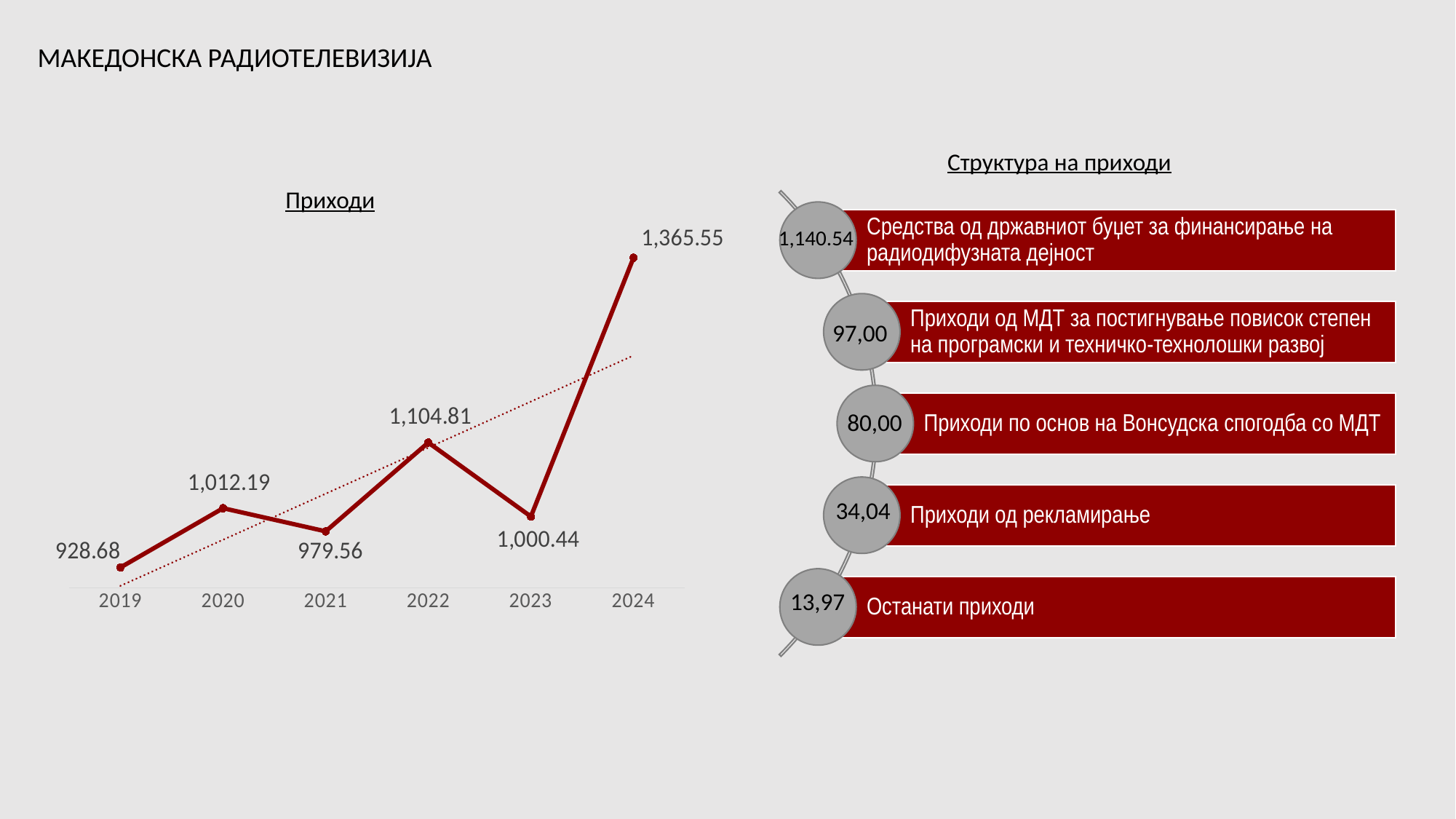
In the 'Приходи' chart, what is the value for 2022? 1,104.81 In the 'Приходи' chart, which year has the highest value? 2024 In the 'Приходи' chart, does the value rise or fall from 2022 to 2023? Fall In the 'Приходи' chart, what is the difference between the values for 2024 and 2023? 365.11 In the 'Приходи' chart, which year has the lowest value? 2019 In the 'Приходи' chart, what is the value for 2021? 979.56 In the 'Приходи' chart, what is the difference between the values for 2022 and 2021? 125.25 In the 'Приходи' chart, what is the value for 2024? 1,365.55 In the 'Приходи' chart, what is the value for 2019? 928.68 How many years are plotted in the 'Приходи' chart? 6 What kind of chart is the 'Приходи' chart? Line chart In the 'Приходи' chart, which is larger, the value for 2020 or the value for 2023? 2020